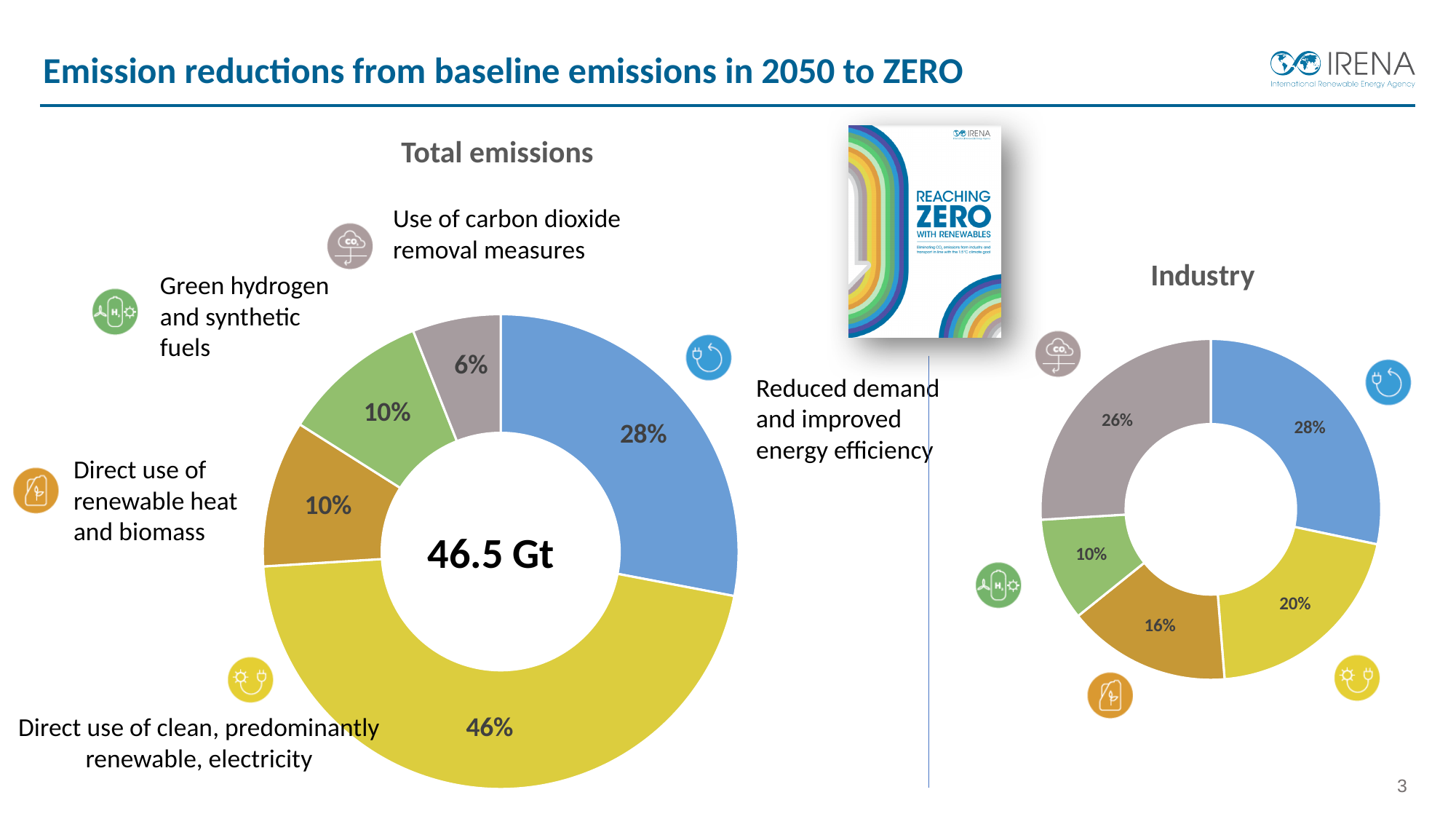
How many segments does the Total emissions chart have? 5 In the Industry chart, what share does the blue segment (reduced demand and improved energy efficiency) represent? 28% In the Total emissions chart, what is the difference in percentage points between direct use of clean electricity and reduced demand and improved energy efficiency? 18 percentage points In the Total emissions chart, which category has the largest share? Direct use of clean, predominantly renewable, electricity In the Total emissions chart, which category has the smallest share? Use of carbon dioxide removal measures What type of chart is the Industry chart? Donut (pie) chart In the Total emissions chart, what share is attributed to direct use of clean, predominantly renewable, electricity? 46% In the Industry chart, what share does the grey segment (carbon dioxide removal measures) represent? 26% In the Industry chart, which is larger: the yellow segment (direct use of clean electricity) or the orange segment (renewable heat and biomass)? The yellow segment (20%) What total value is shown in the centre of the Total emissions chart? 46.5 Gt In the Total emissions chart, what share is attributed to use of carbon dioxide removal measures? 6% In the Total emissions chart, what share is attributed to reduced demand and improved energy efficiency? 28%